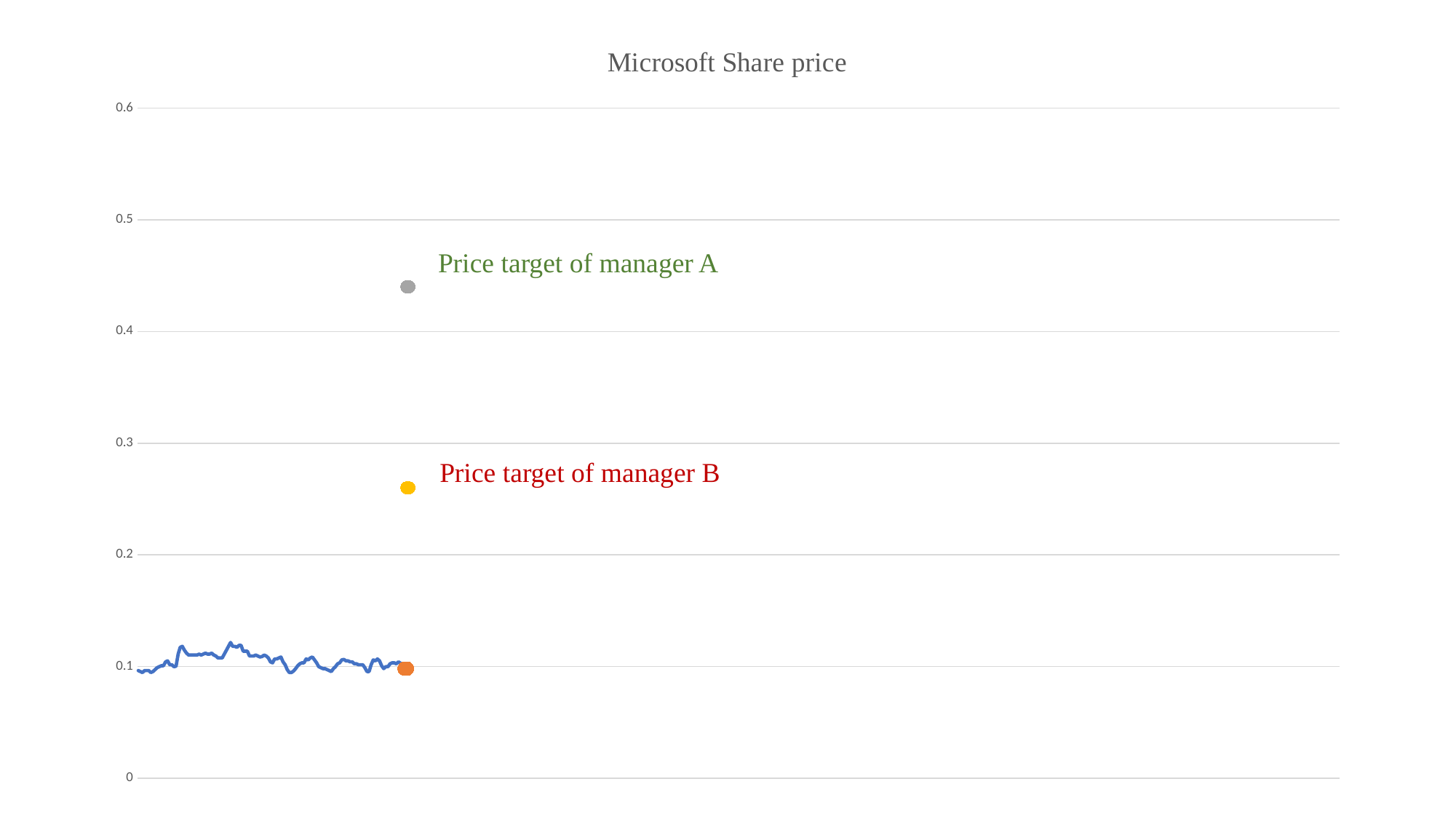
Is the Microsoft share price line greater or less than 0.2 throughout the plotted period? less What kind of chart is shown on the slide? line chart Is the price target of manager B greater or less than 0.2? greater Is the price target of manager A greater or less than 0.4? greater Which price target is higher, manager A's or manager B's? manager A What is the title of the chart? Microsoft Share price What is the highest value shown on the vertical axis? 0.6 Is the price target of manager B greater or less than the plotted share price? greater